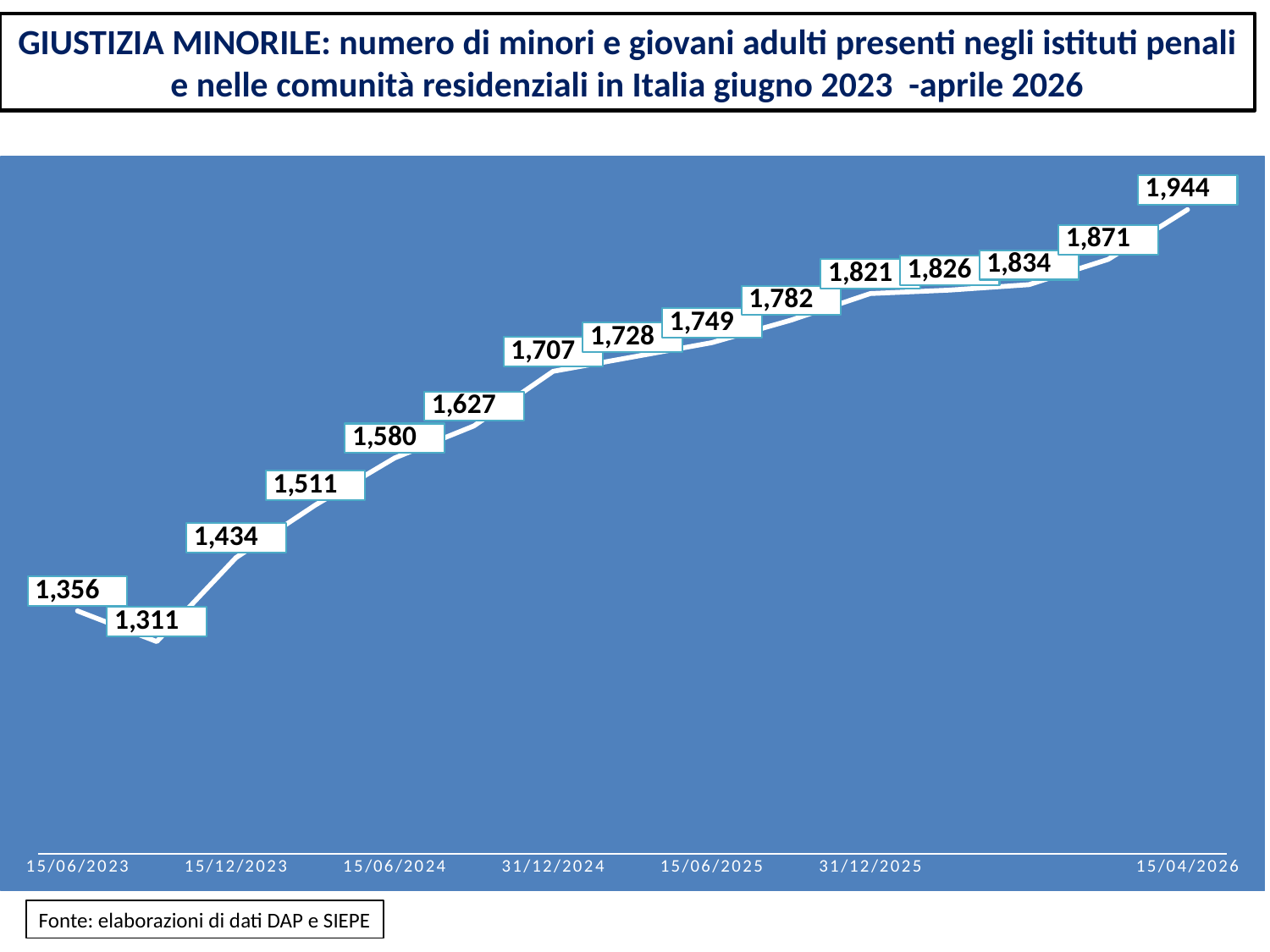
What is the value of the point immediately after 1,782? 1,821 What kind of chart is shown on the slide? line chart What is the lowest value shown on the chart? 1,311 What is the value at the first point of the line, dated 15/06/2023? 1,356 What is the difference between the last value (1,944) and the first value (1,356)? 588 How many data points are plotted on the line? 15 Overall, do the values rise or fall from 15/06/2023 to 15/04/2026? rise Which is larger, the first value (1,356) or the second value (1,311)? 1,356 What is the highest value shown on the chart? 1,944 What is the difference between the lowest value (1,311) and the highest value (1,944)? 633 What is the value at the last point of the line, dated 15/04/2026? 1,944 What source is cited below the chart? Fonte: elaborazioni di dati DAP e SIEPE